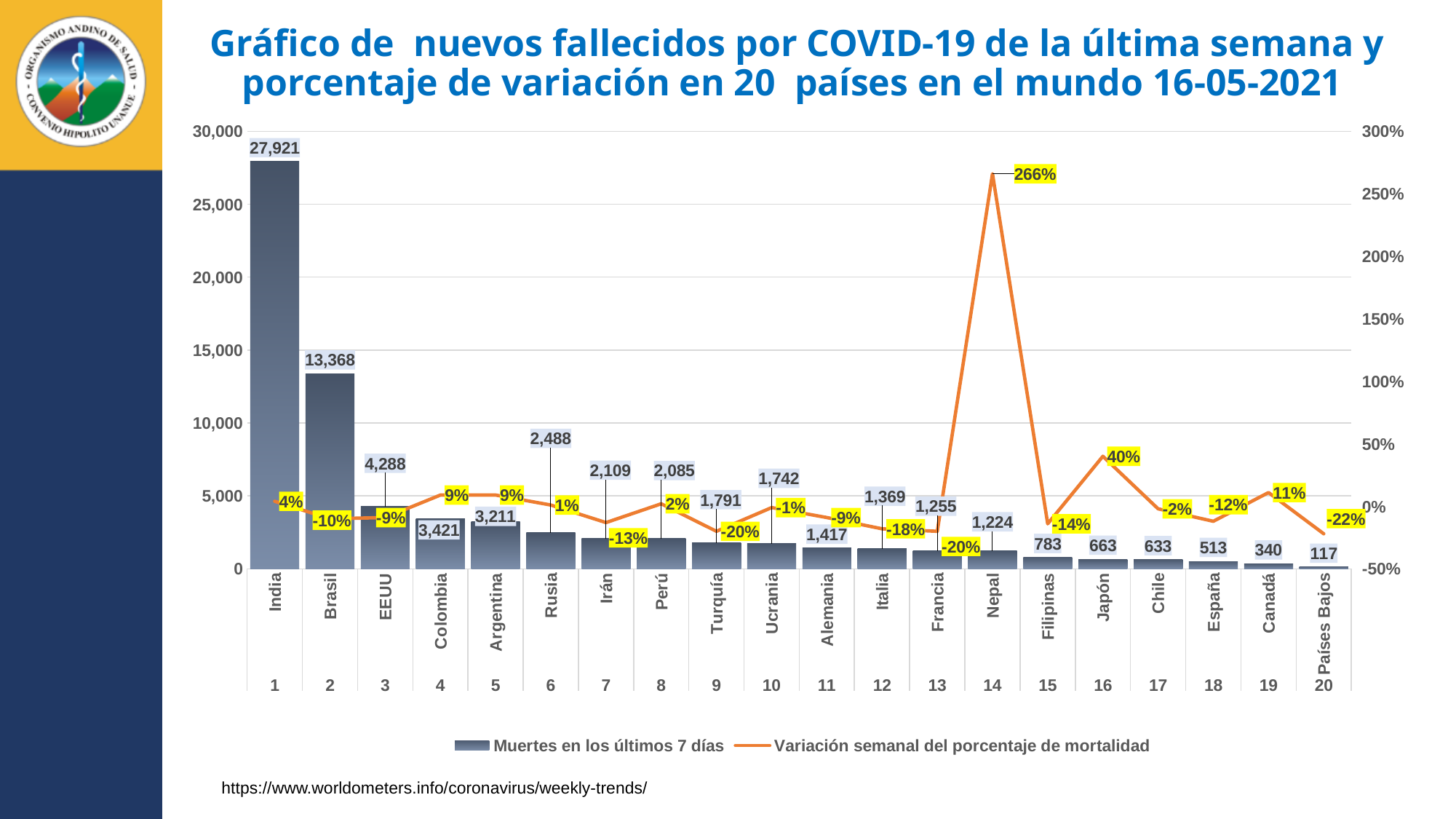
Which has more 'Muertes en los últimos 7 días', Colombia or Argentina? Colombia What is the value of 'Muertes en los últimos 7 días' for Perú? 2,085 How many series does the legend list? 2 Which country has the lowest value of 'Muertes en los últimos 7 días'? Países Bajos Is the value of 'Muertes en los últimos 7 días' for EEUU greater or less than 5,000? less What is the difference in 'Muertes en los últimos 7 días' between India and Brasil? 14,553 How many countries are shown on the chart? 20 What is the value of 'Muertes en los últimos 7 días' for India? 27,921 What kind of chart is this? Combined bar and line chart What is the 'Variación semanal del porcentaje de mortalidad' for Nepal? 266% What is the 'Variación semanal del porcentaje de mortalidad' for Japón? 40% Which country has the highest 'Variación semanal del porcentaje de mortalidad'? Nepal